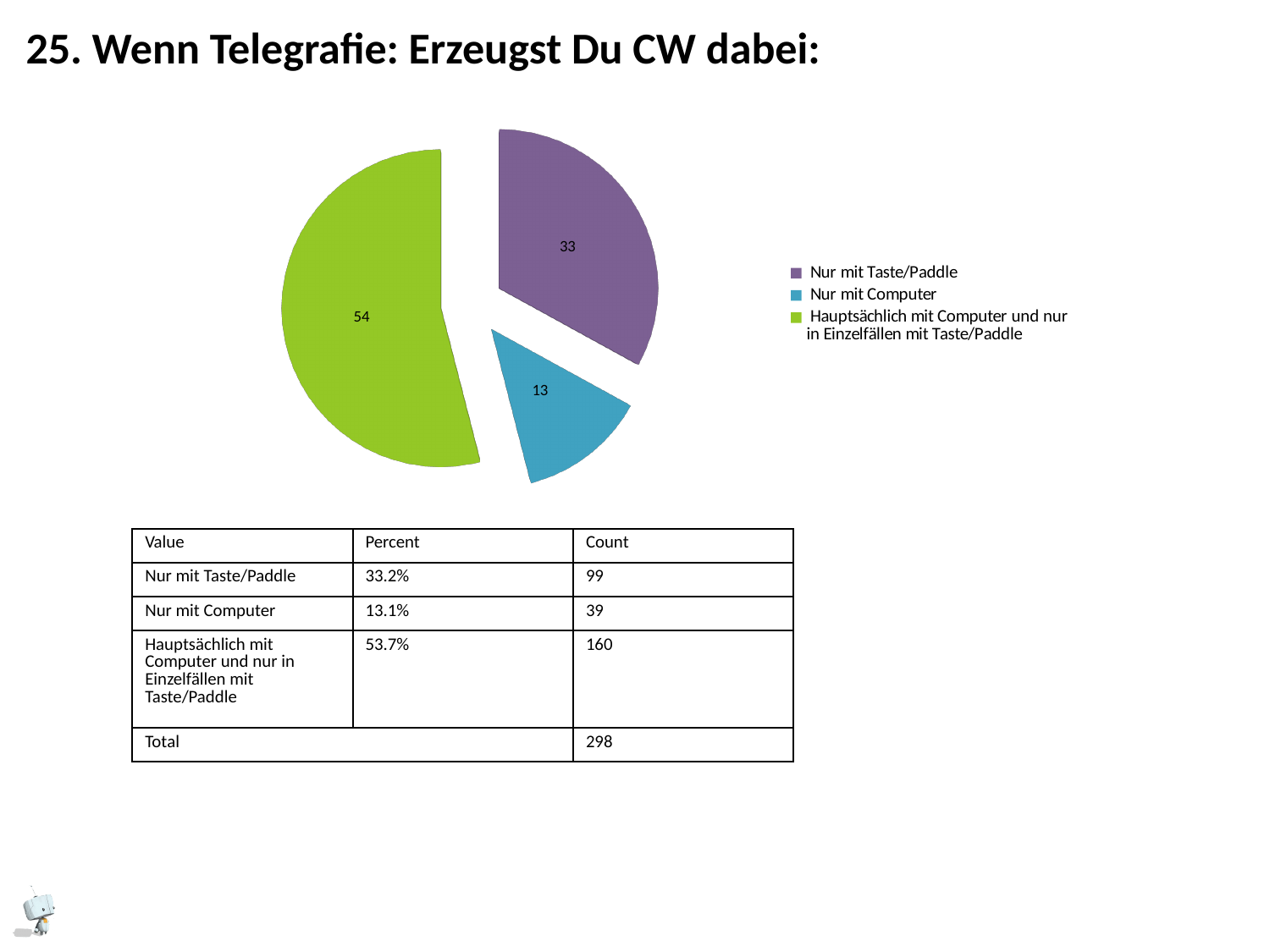
What value is labelled on the pie slice for Nur mit Computer? 13 How many slices does the pie chart have? 3 Which category has the largest slice of the pie? Hauptsächlich mit Computer und nur in Einzelfällen mit Taste/Paddle What kind of chart is shown on the slide? pie chart What value is labelled on the pie slice for Nur mit Taste/Paddle? 33 What is the difference between the labelled values for Hauptsächlich mit Computer und nur in Einzelfällen mit Taste/Paddle and Nur mit Taste/Paddle? 21 What value is labelled on the pie slice for Hauptsächlich mit Computer und nur in Einzelfällen mit Taste/Paddle? 54 How many entries does the legend list? 3 What colour is the slice for Nur mit Computer? blue What is the title of the slide containing the pie chart? 25. Wenn Telegrafie: Erzeugst Du CW dabei: Which category has the smallest slice of the pie? Nur mit Computer Which slice is larger: Nur mit Taste/Paddle or Nur mit Computer? Nur mit Taste/Paddle